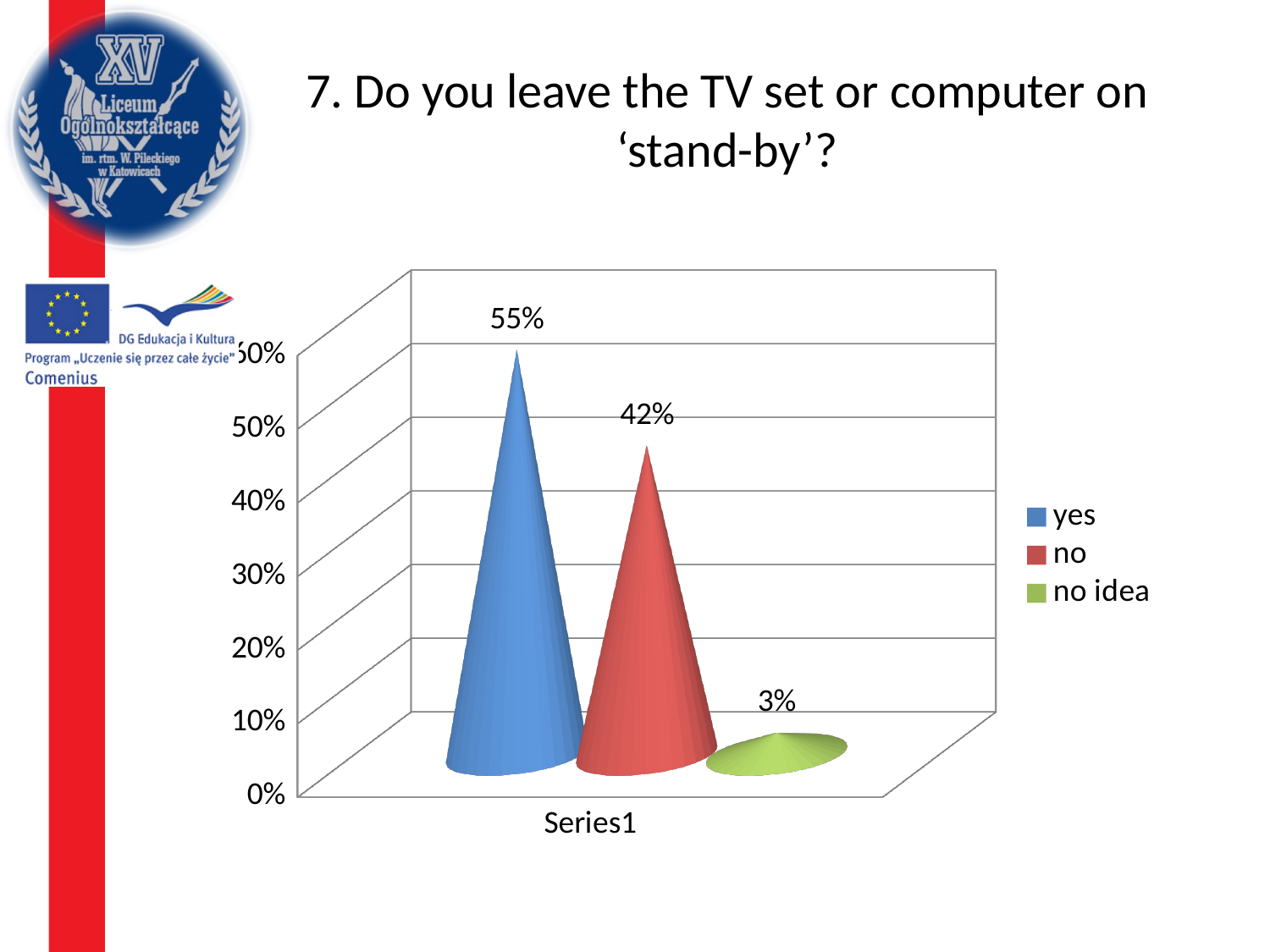
How many series does the legend list? 3 Is the value for 'no' greater or less than 40%? greater What kind of chart is shown on the slide? bar chart Which response has the highest value? yes What is the difference between the 'no' and 'no idea' percentages? 39% Which is larger, the value for 'yes' or the value for 'no'? yes What percentage of respondents answered 'no idea'? 3% What is the difference between the 'yes' and 'no' percentages? 13% What percentage of respondents answered 'no'? 42% Which response has the lowest value? no idea What percentage of respondents answered 'yes'? 55% What colour represents the 'no idea' response in the legend? green